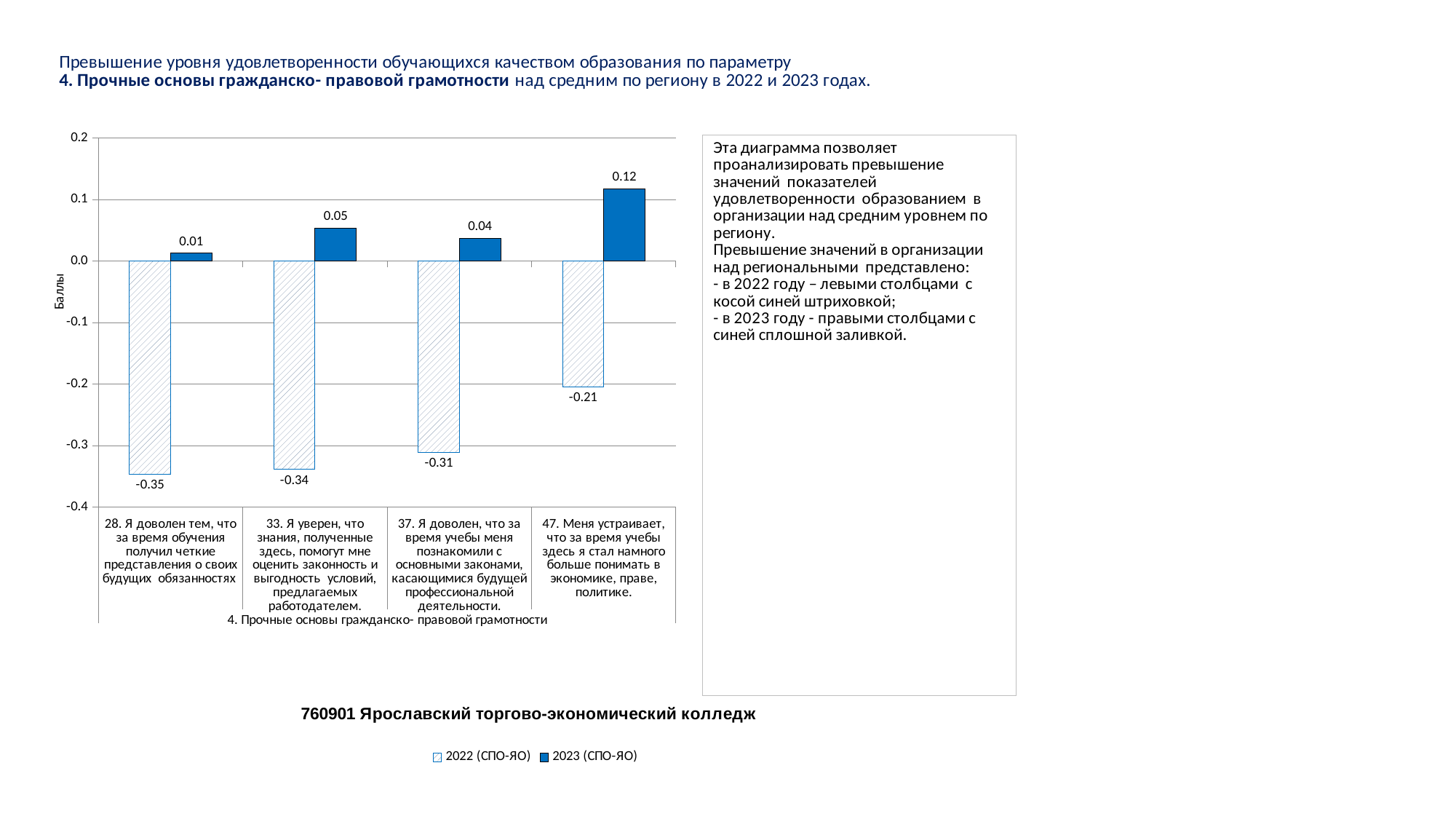
What is the 2023 (СПО-ЯО) value for item 47 (Меня устраивает, что за время учебы здесь я стал намного больше понимать в экономике, праве, политике)? 0.12 How many series does the chart legend list? 2 What type of chart is shown on the slide? Bar chart What is the 2022 (СПО-ЯО) value for item 28 (Я доволен тем, что за время обучения получил четкие представления о своих будущих обязанностях)? -0.35 How many items (categories) are shown on the x axis of the chart? 4 What is the 2023 (СПО-ЯО) value for item 33 (Я уверен, что знания, полученные здесь, помогут мне оценить законность и выгодность условий, предлагаемых работодателем)? 0.05 What is the difference between the 2023 (СПО-ЯО) value and the 2022 (СПО-ЯО) value for item 47? 0.33 Which item has the highest 2023 (СПО-ЯО) value? 47. Меня устраивает, что за время учебы здесь я стал намного больше понимать в экономике, праве, политике. Which is larger for item 33: the 2022 (СПО-ЯО) value or the 2023 (СПО-ЯО) value? 2023 (СПО-ЯО) Which item has the lowest 2022 (СПО-ЯО) value? 28. Я доволен тем, что за время обучения получил четкие представления о своих будущих обязанностях What is the label of the vertical axis of the chart? Баллы What is the 2022 (СПО-ЯО) value for item 37 (Я доволен, что за время учебы меня познакомили с основными законами, касающимися будущей профессиональной деятельности)? -0.31